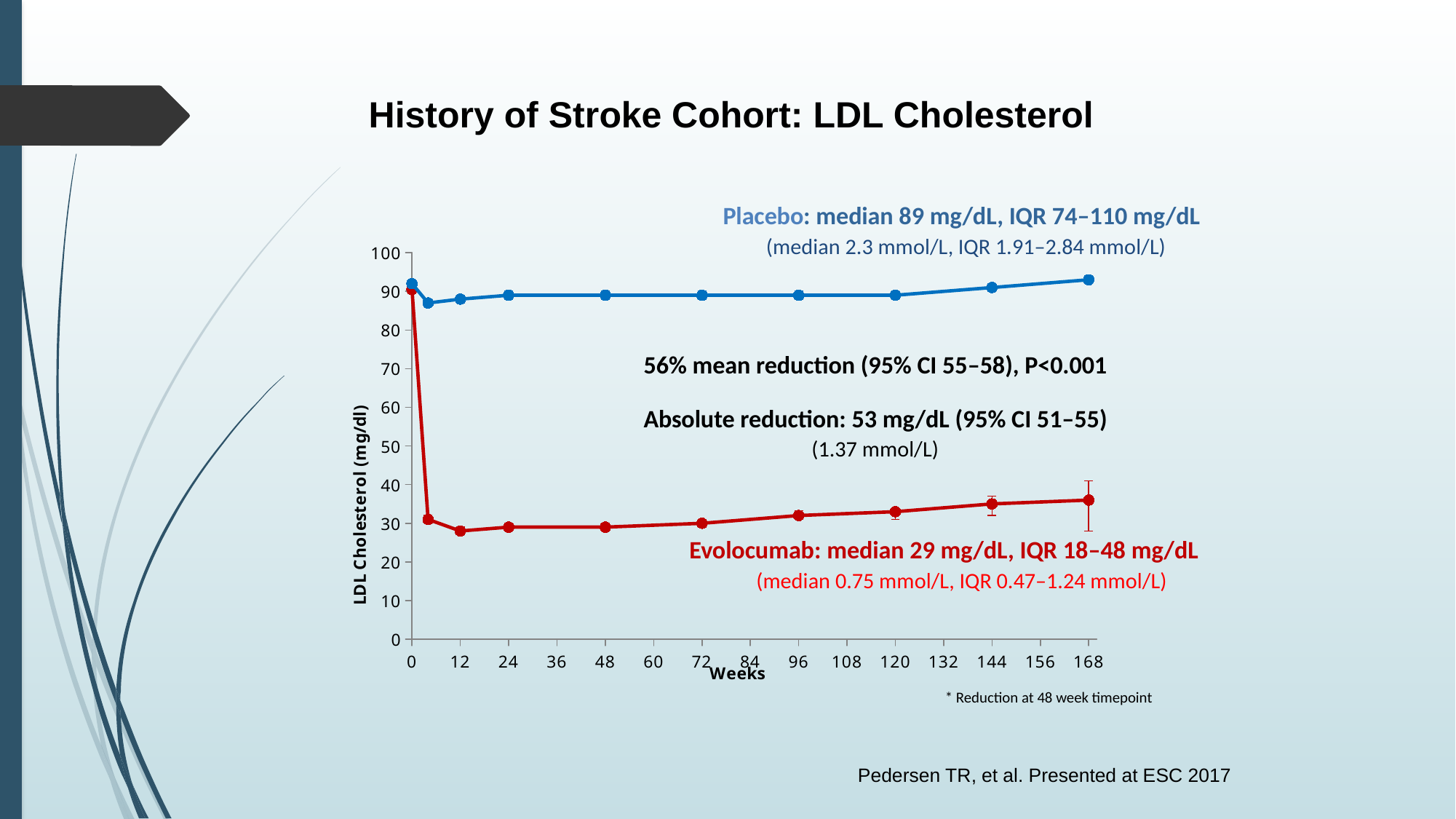
What kind of chart is shown on the slide? line chart What absolute reduction in LDL cholesterol is stated on the slide? 53 mg/dL Does the Evolocumab line rise or fall between week 12 and week 168? rise What percentage mean reduction is stated on the slide? 56% Is the Evolocumab value at week 48 greater or less than 40? less What is the median LDL cholesterol for the Placebo group, as stated on the slide? 89 mg/dL What is the label of the y axis? LDL Cholesterol (mg/dL) What is the median LDL cholesterol for the Evolocumab group, as stated on the slide? 29 mg/dL At week 96, which series has the higher LDL cholesterol value, Placebo or Evolocumab? Placebo Is the Evolocumab value at week 168 greater or less than 30? greater Is the Placebo value at week 168 greater or less than 90? greater How many series are plotted on the chart? 2